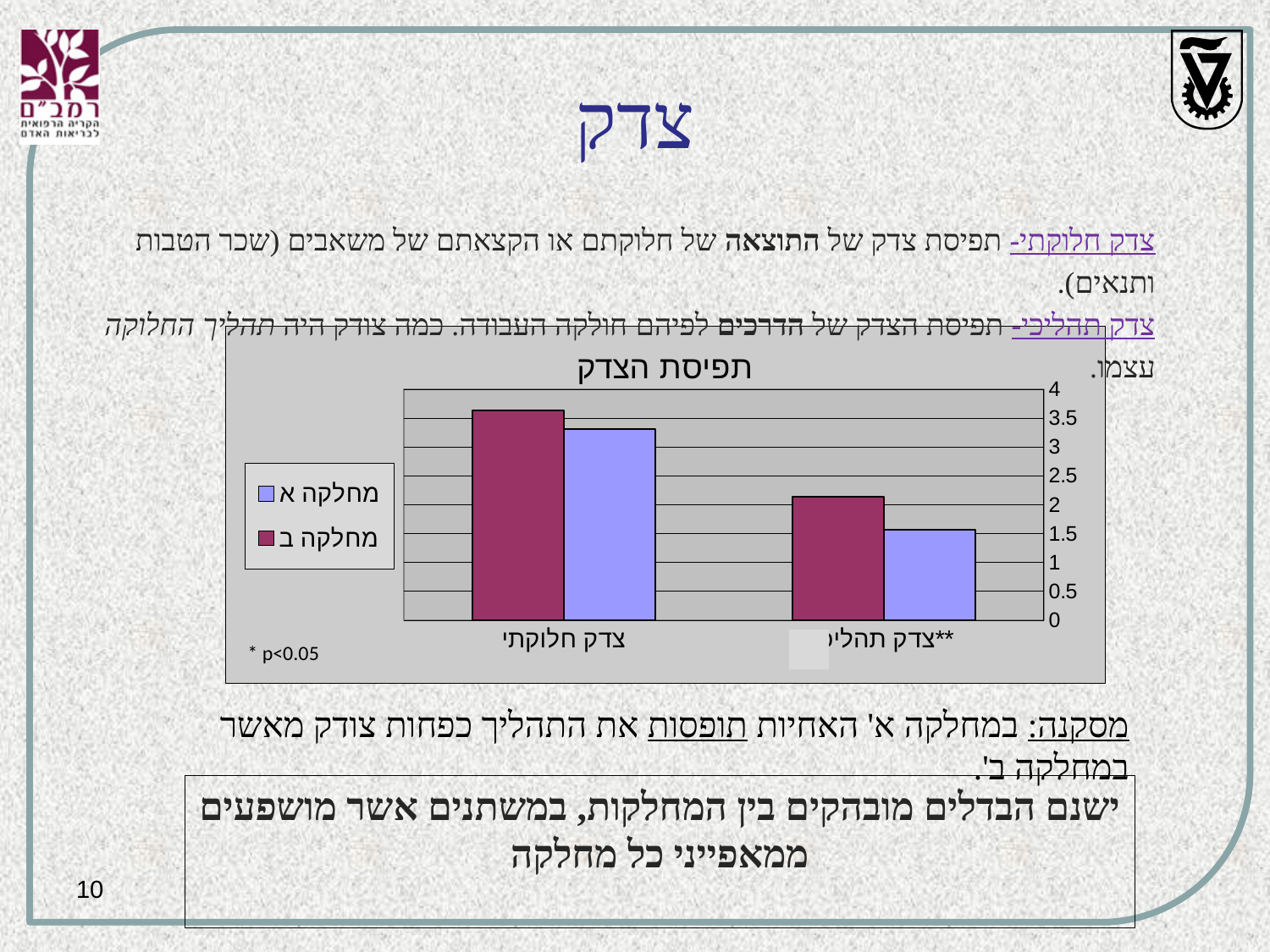
Is the value for מחלקה ב in צדק תהליכי greater or less than 2.5? less For צדק חלוקתי, which series has the larger value, מחלקה א or מחלקה ב? מחלקה ב For צדק תהליכי, which series has the larger value, מחלקה א or מחלקה ב? מחלקה ב Is the value for מחלקה א in צדק תהליכי greater or less than 2? less How many categories are shown on the x axis of the chart? 2 Which bar is the shortest in the chart? מחלקה א for צדק תהליכי Which series is shown in the maroon colour in the chart? מחלקה ב What kind of chart is shown on the slide? bar chart What is the title of the chart? תפיסת הצדק Which bar is the tallest in the chart? מחלקה ב for צדק חלוקתי How many series does the chart's legend list? 2 Is the value for מחלקה א in צדק חלוקתי greater or less than 3? greater